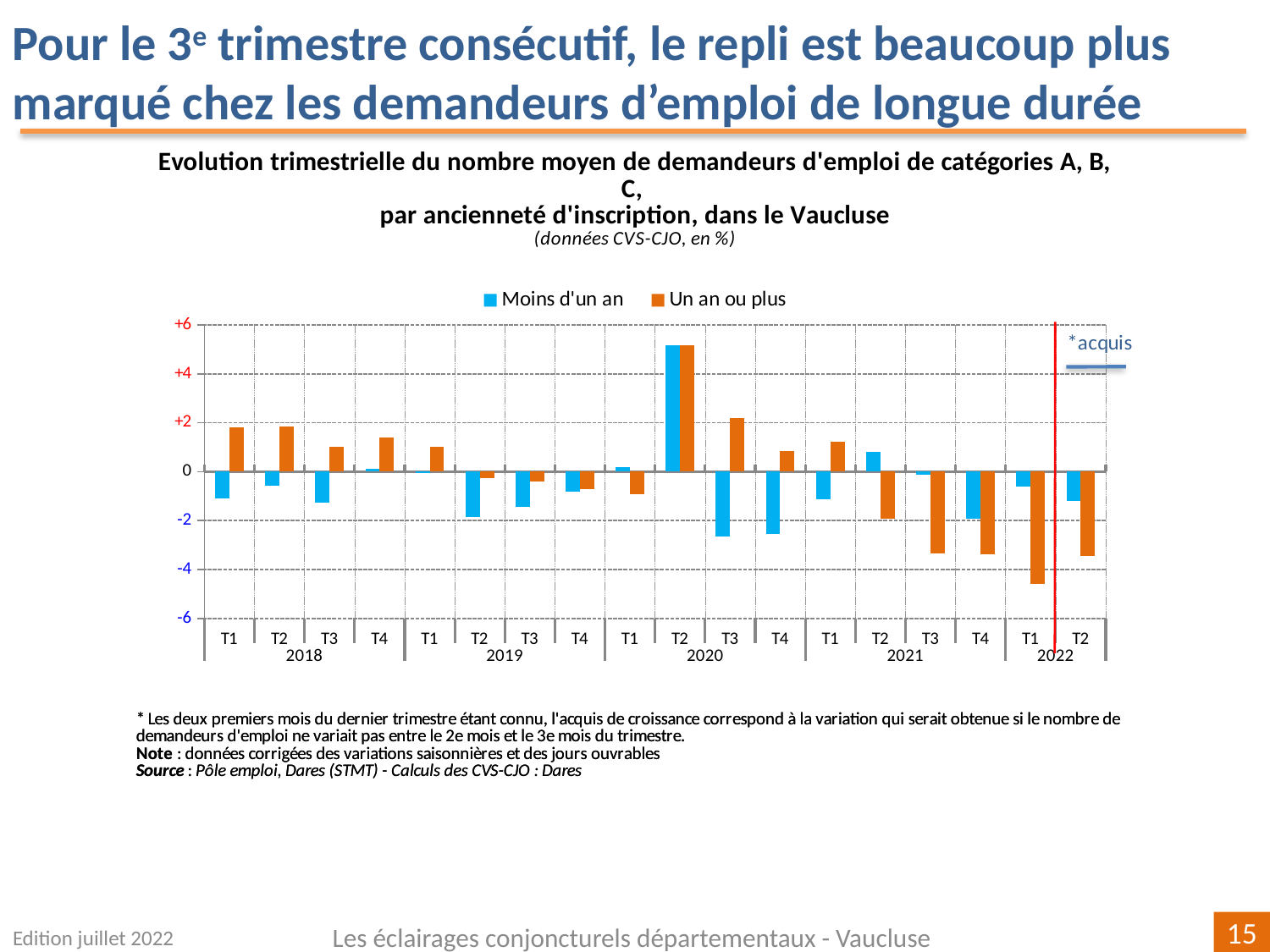
In which quarter does the 'Moins d'un an' series reach its highest value? T2 2020 What kind of chart is shown on the slide? Bar chart Which series is drawn in orange? Un an ou plus How many quarters are plotted along the x axis? 18 Is the value for 'Moins d'un an' in T2 2020 greater or less than +4? greater Is the value for 'Un an ou plus' in T1 2022 greater or less than -4? less In T3 2020, which series has the larger value, 'Moins d'un an' or 'Un an ou plus'? Un an ou plus In which quarter does the 'Un an ou plus' series reach its lowest value? T1 2022 What are the two series named in the legend? Moins d'un an; Un an ou plus In which quarter does the 'Un an ou plus' series reach its highest value? T2 2020 How many series does the legend list? 2 Is the value for 'Un an ou plus' in T3 2021 greater or less than -2? less